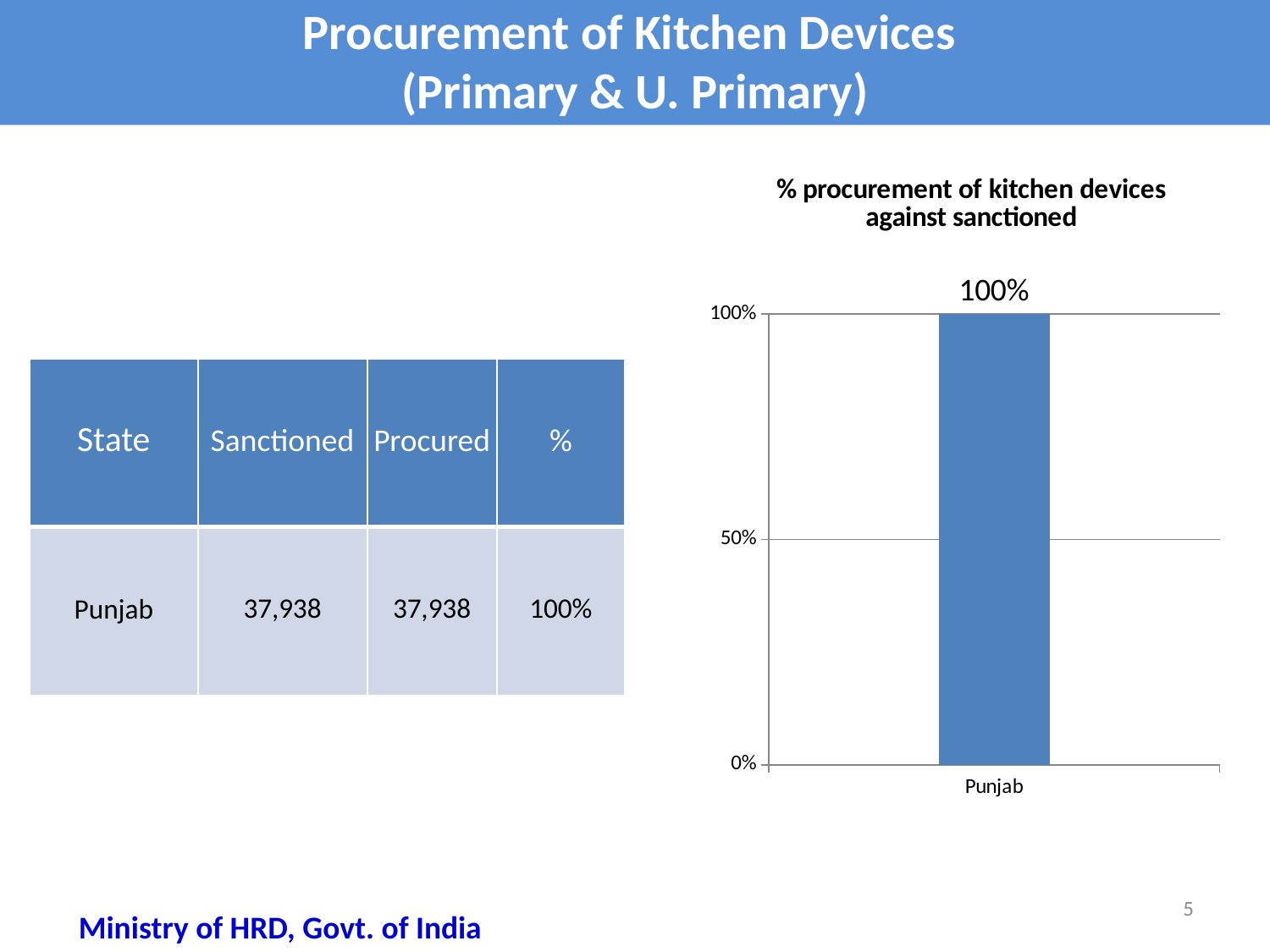
What is the highest value shown on the chart's y axis? 100% What is the value for Punjab in the chart? 100% Is the value for Punjab greater or less than 50%? greater Which state is shown on the x axis of the chart? Punjab What kind of chart is shown on the slide? bar chart What is the title of the chart? % procurement of kitchen devices against sanctioned How many categories are plotted in the chart? 1